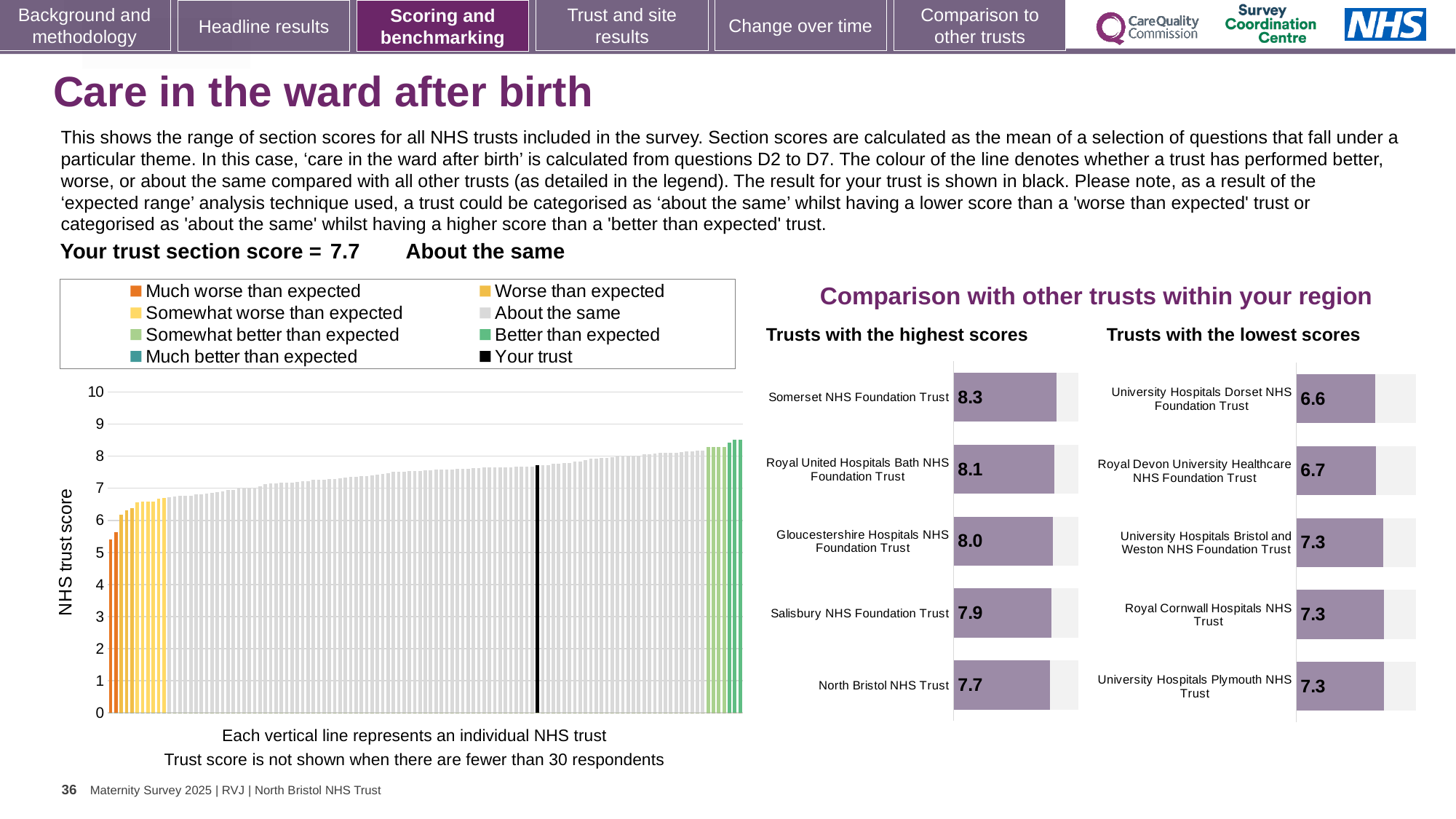
In the 'Trusts with the highest scores' chart, which trust has the lowest score? North Bristol NHS Trust In the main NHS trust score chart, is the value of the rightmost bar greater or less than 8? greater In the main NHS trust score chart, what is the section score for your trust (the black bar)? 7.7 In the 'Trusts with the highest scores' chart, what is the score for Somerset NHS Foundation Trust? 8.3 How many entries does the legend of the main NHS trust score chart list? 8 In the main NHS trust score chart, is the value of the leftmost bar greater or less than 6? less What kind of chart is the main NHS trust score chart? Bar chart How many trusts are listed in the 'Trusts with the highest scores' chart? 5 In the 'Trusts with the lowest scores' chart, which trust has the lowest score? University Hospitals Dorset NHS Foundation Trust In the 'Trusts with the lowest scores' chart, which has the higher score: Royal Devon University Healthcare NHS Foundation Trust or Royal Cornwall Hospitals NHS Trust? Royal Cornwall Hospitals NHS Trust In the 'Trusts with the lowest scores' chart, what is the score for University Hospitals Dorset NHS Foundation Trust? 6.6 In the 'Trusts with the highest scores' chart, what is the difference between the scores of Somerset NHS Foundation Trust and North Bristol NHS Trust? 0.6